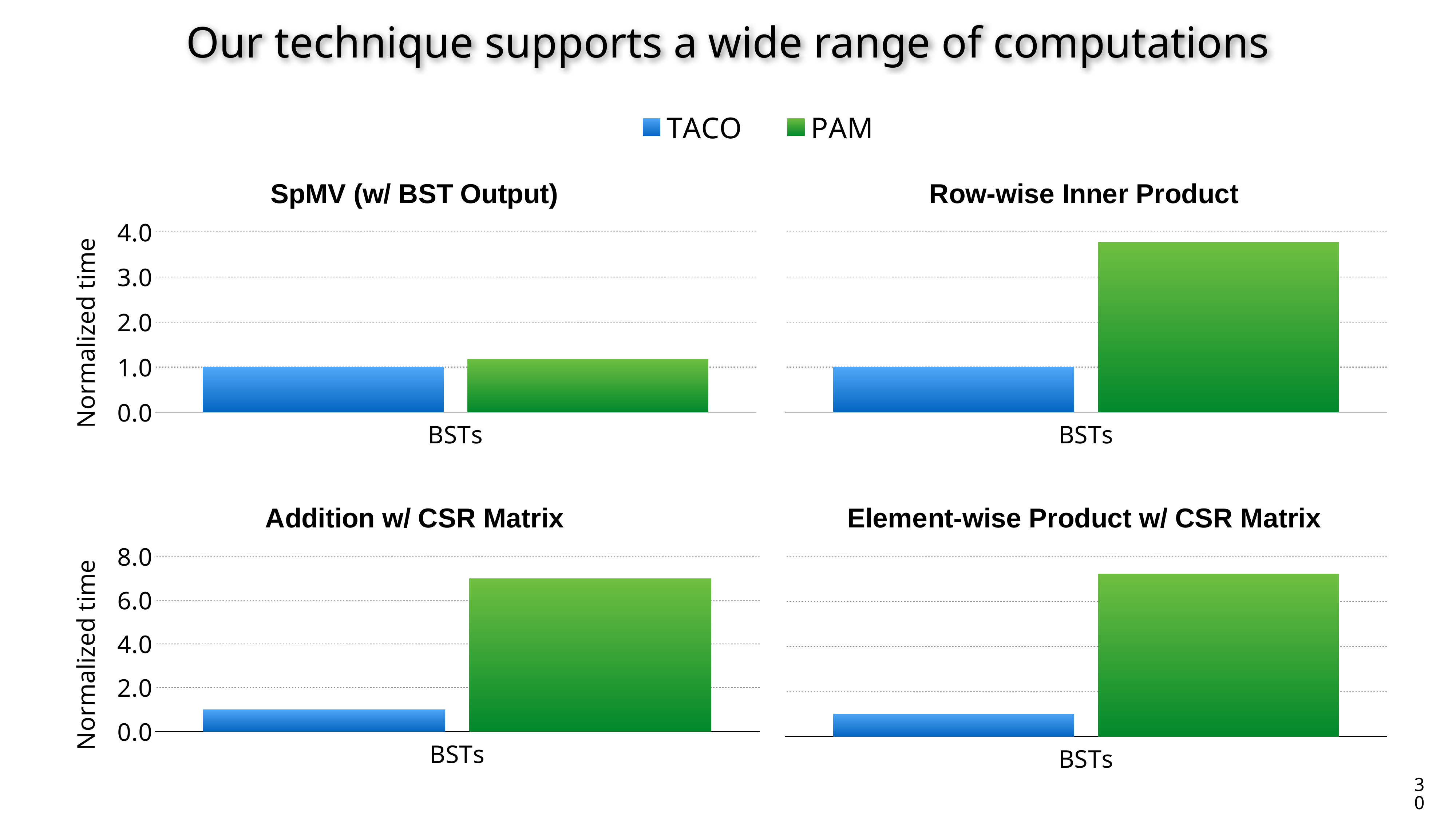
In the Addition w/ CSR Matrix chart, is the value for PAM greater or less than 6.0? greater How many categories are shown on the x axis of the SpMV (w/ BST Output) chart? 1 In the Row-wise Inner Product chart, is the value for PAM greater or less than 3.0? greater In the Element-wise Product w/ CSR Matrix chart, is the value for TACO greater or less than 2.0? less In the Row-wise Inner Product chart, which series has the smaller value, TACO or PAM? TACO In the SpMV (w/ BST Output) chart, what is the normalized time for TACO? 1.0 What kind of chart is the Element-wise Product w/ CSR Matrix chart? Bar chart How many series does the legend at the top of the slide list? 2 In the Row-wise Inner Product chart, what is the normalized time for TACO? 1.0 What is the y-axis label of the Addition w/ CSR Matrix chart? Normalized time In the Addition w/ CSR Matrix chart, which series has the larger value, TACO or PAM? PAM